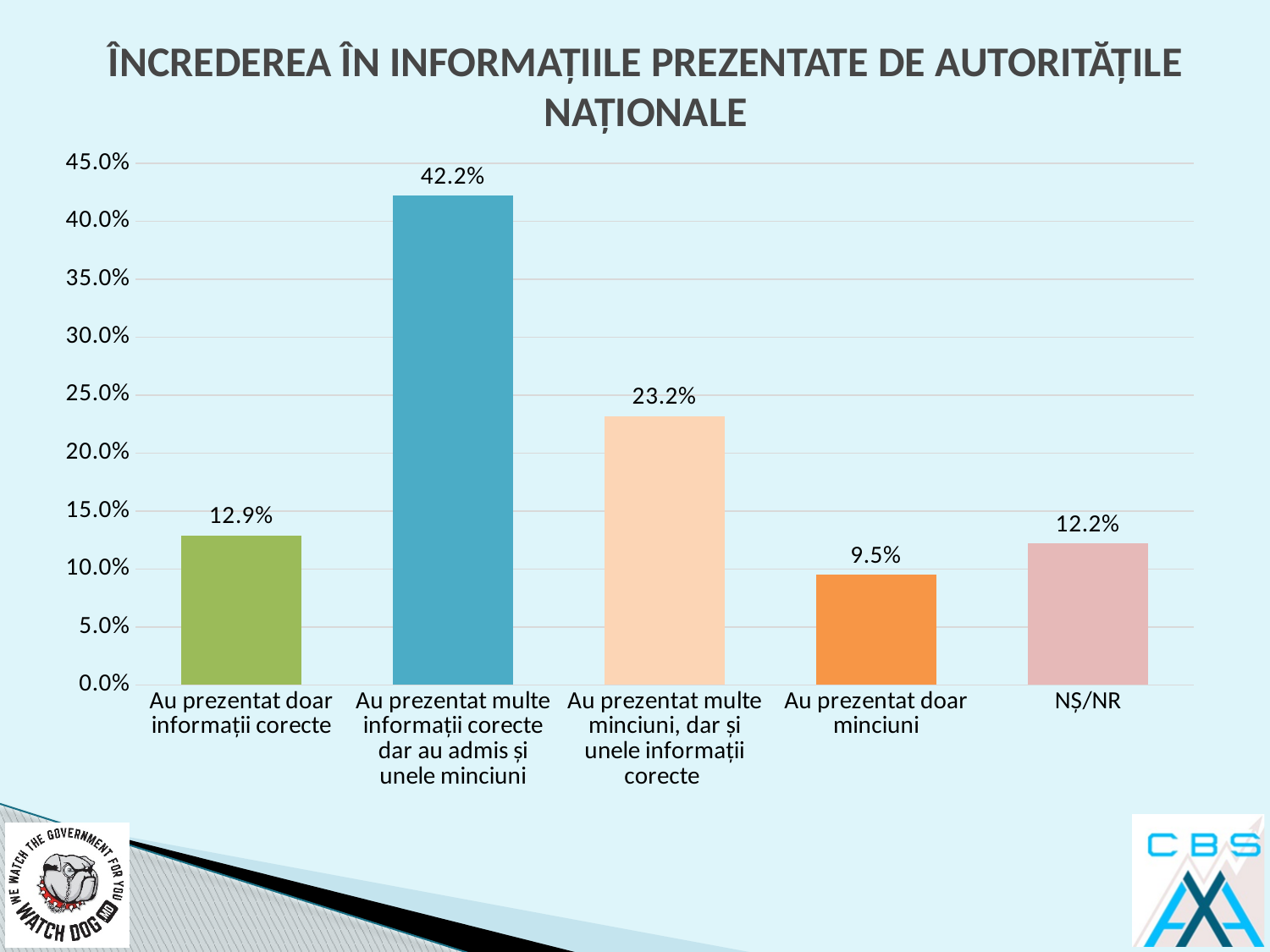
What is the value for "Au prezentat doar minciuni"? 9.5% What is the difference between the values for "Au prezentat multe informații corecte dar au admis și unele minciuni" and "Au prezentat multe minciuni, dar și unele informații corecte"? 19.0% Which category has the highest value? Au prezentat multe informații corecte dar au admis și unele minciuni What is the value for "NȘ/NR"? 12.2% What is the title of the chart? ÎNCREDEREA ÎN INFORMAȚIILE PREZENTATE DE AUTORITĂȚILE NAȚIONALE Is the value for "Au prezentat multe minciuni, dar și unele informații corecte" greater or less than 20.0%? greater Which category has the lowest value? Au prezentat doar minciuni How many categories are shown on the chart? 5 What kind of chart is shown on the slide? bar chart What is the value for "Au prezentat doar informații corecte"? 12.9% Which is larger: the value for "Au prezentat doar informații corecte" or the value for "NȘ/NR"? Au prezentat doar informații corecte What is the value for "Au prezentat multe informații corecte dar au admis și unele minciuni"? 42.2%